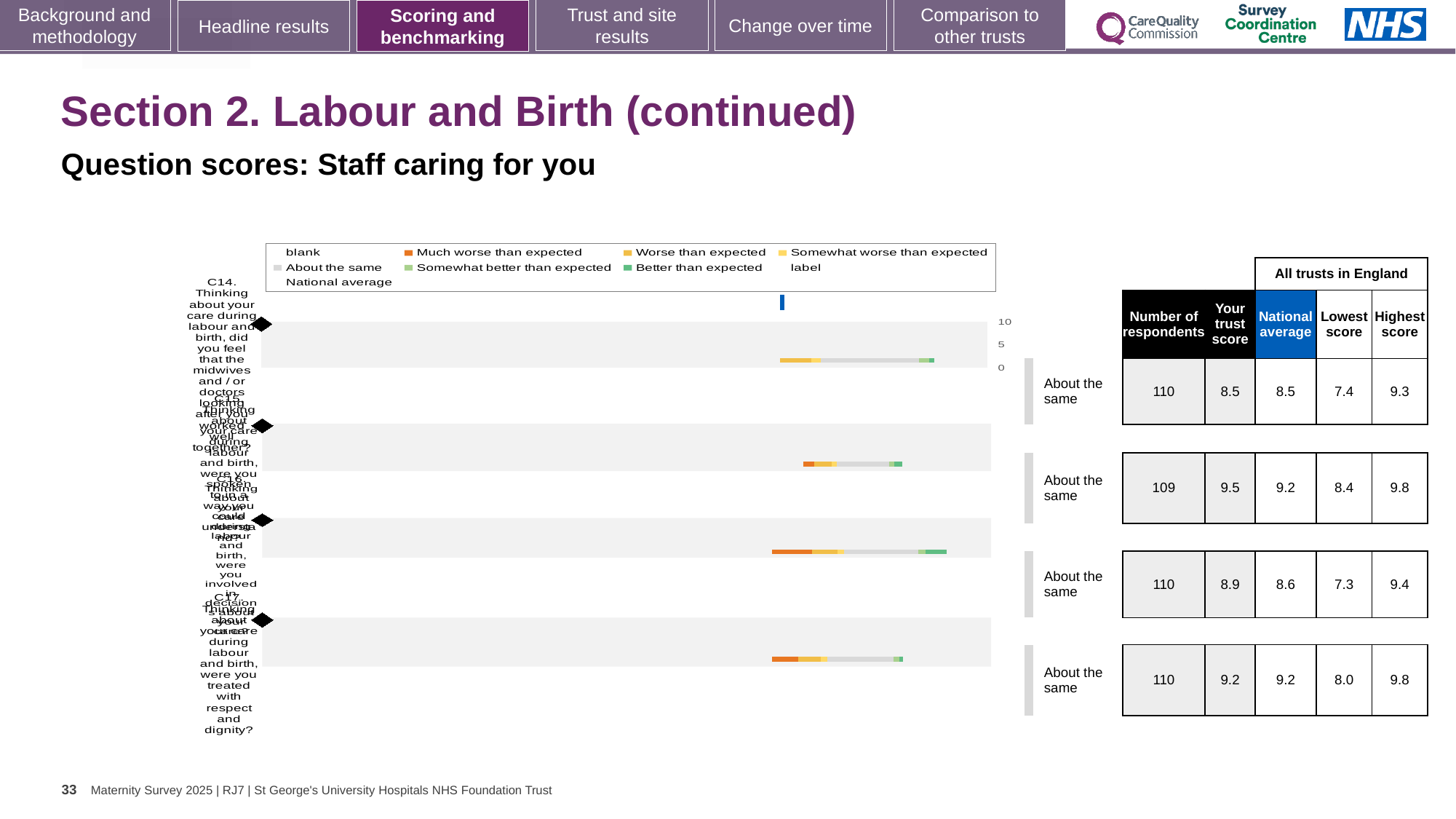
How many respondents are listed for the second row from the top? 109 How many question rows (bars) does the chart show? 4 What is the 'Your trust score' for the first row (C14, midwives and/or doctors worked well together)? 8.5 Which row has the highest 'Your trust score'? the second row from the top (9.5) What is the national average for the last row (C17, treated with respect and dignity)? 9.2 For the third row from the top, which is larger: the trust score or the national average? the trust score (8.9) In the chart legend, what colour represents 'Much worse than expected'? orange In the chart legend, what colour represents 'Better than expected'? green What kind of chart is shown on the slide? bar chart What benchmark category is shown for the first row (C14)? About the same How many of the rows are rated 'About the same'? 4 For the first row (C14), what is the difference between the highest score and the lowest score across all trusts in England? 1.9